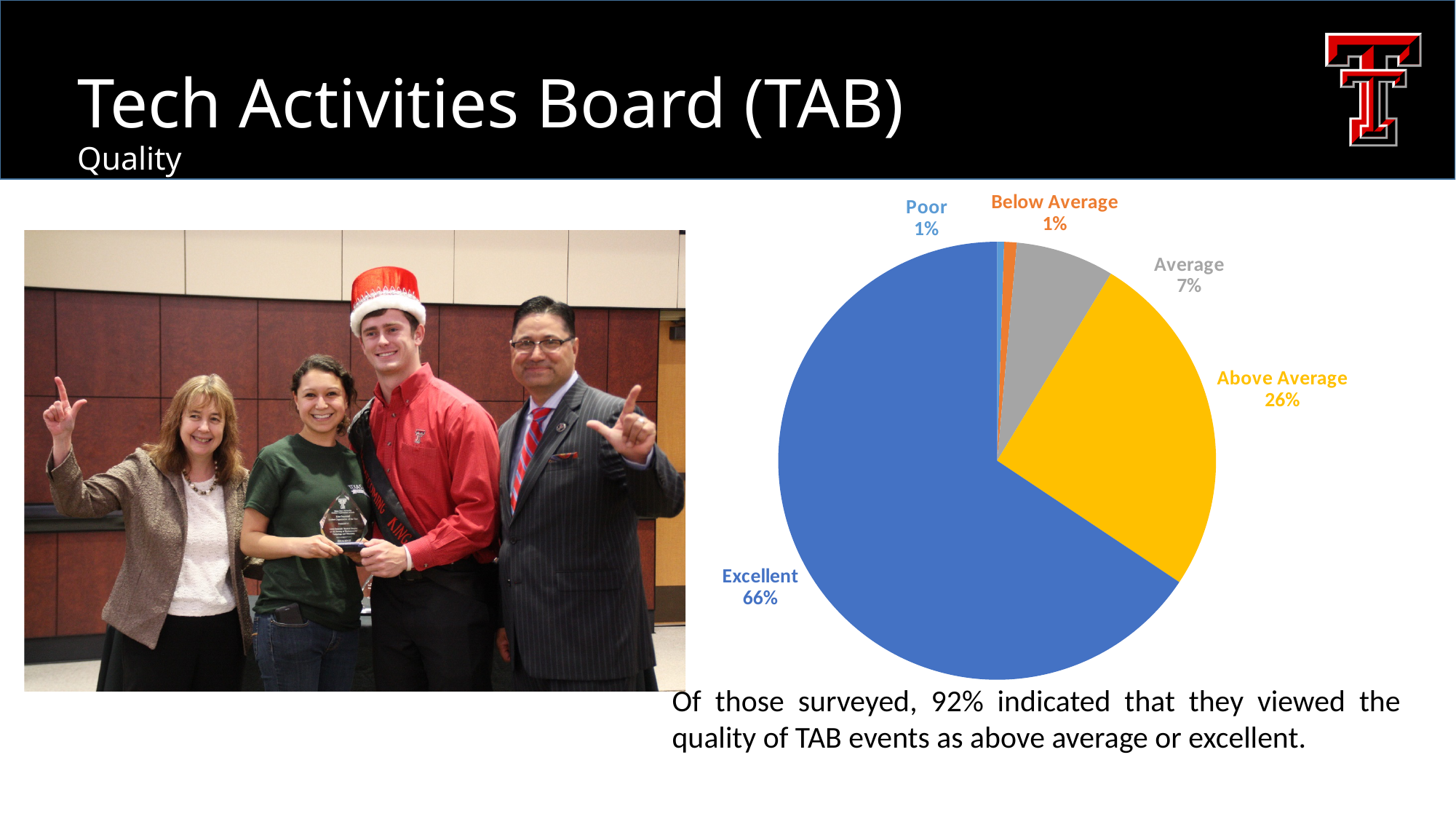
What share of the pie is labelled Average? 7% What share of the pie is labelled Excellent? 66% Which category has the largest slice of the pie? Excellent What colour is the Above Average slice? yellow Which is larger, the Average slice or the Above Average slice? Above Average What kind of chart is shown on the slide? pie chart What share of the pie is labelled Below Average? 1% What colour is the Excellent slice? blue How many slices does the pie chart have? 5 What is the difference between the Excellent and Above Average shares? 40% What share of the pie is labelled Above Average? 26% What is the combined share of the Excellent and Above Average slices? 92%